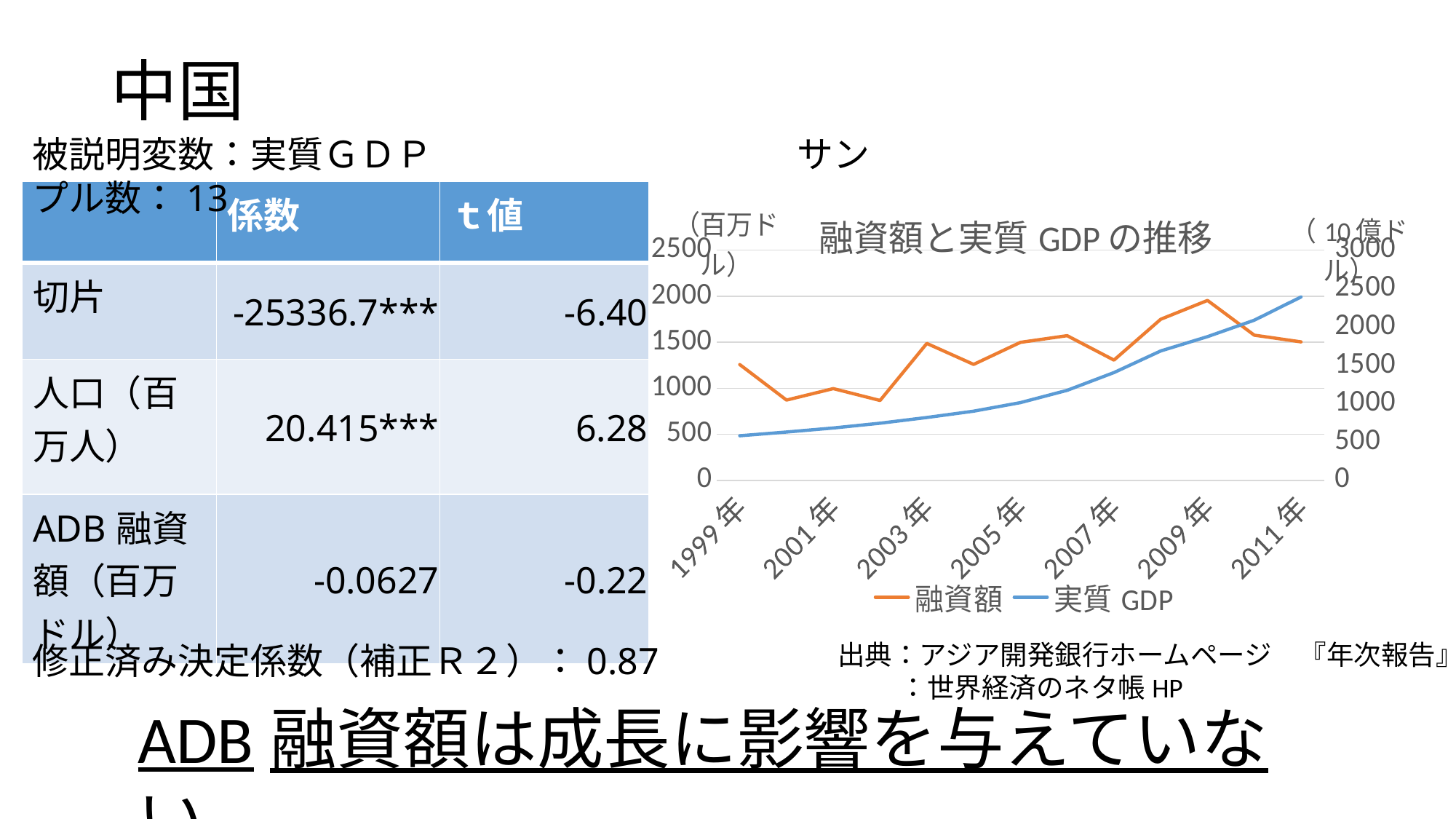
Is the 融資額 value for 2009年 greater or less than 1500 on the left axis? greater How many year labels are shown on the x axis of the chart? 7 How many series does the legend of the chart list? 2 In which year is the 実質GDP series at its highest? 2011年 Is the 融資額 value for 1999年 greater or less than 1000 on the left axis? greater What kind of chart is shown on the slide? line chart Does the 実質GDP series rise or fall from 1999年 to 2011年? rise Which series is drawn in orange in the chart? 融資額 What is the title of the chart? 融資額と実質GDPの推移 In which year is the 実質GDP series at its lowest? 1999年 Is the 実質GDP value for 1999年 greater or less than 1000 on the right axis? less In which year does the 融資額 series reach its highest value? 2009年